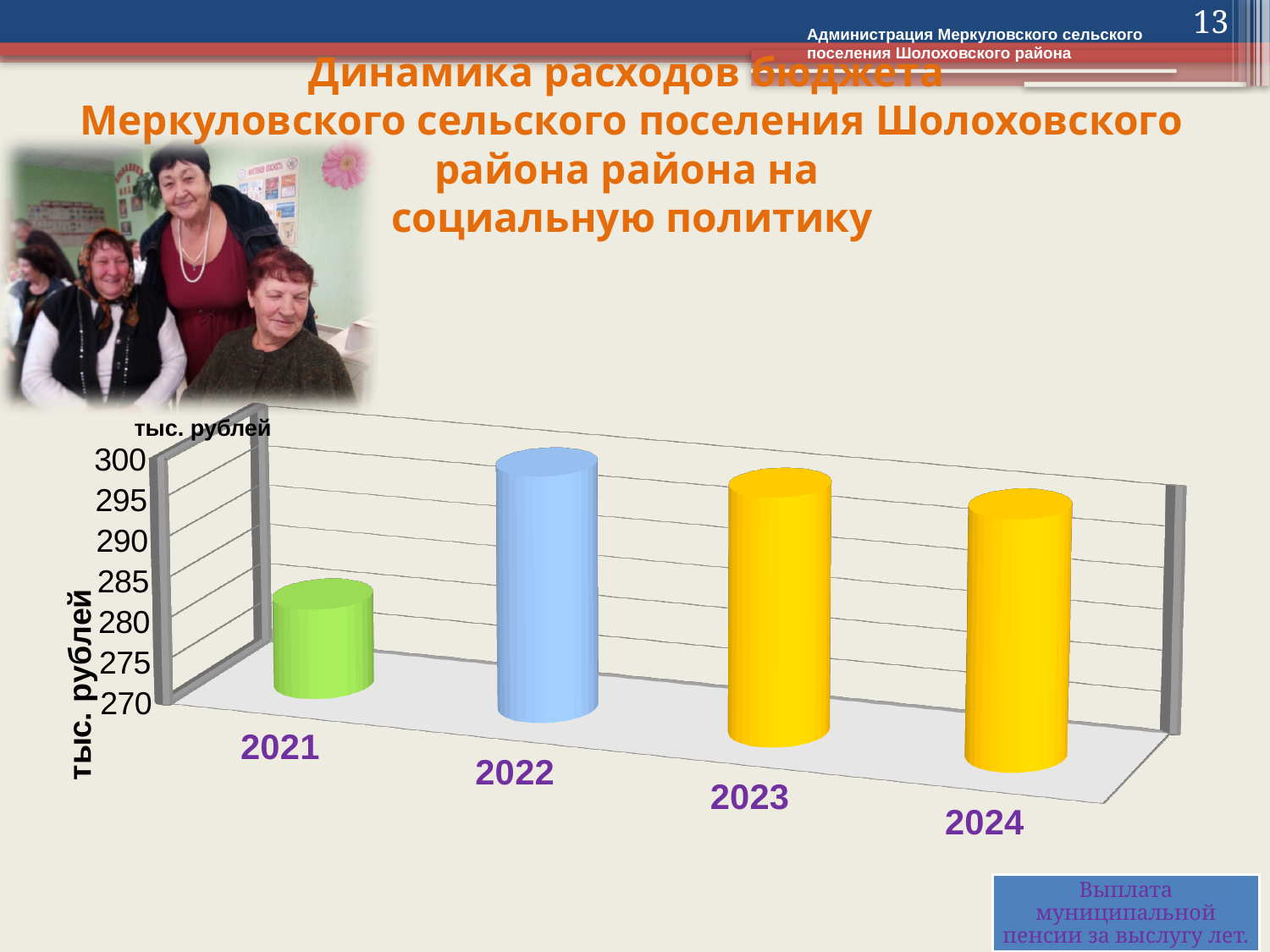
Which year has the lowest value on the chart? 2021 What unit is shown on the vertical axis of the chart? тыс. рублей What kind of chart is shown on the slide? bar chart Which is larger, the value for 2024 or the value for 2021? 2024 Which is larger, the value for 2021 or the value for 2022? 2022 Is the value for 2022 greater or less than 290? greater Is the value for 2024 greater or less than 285? greater Is the value for 2021 greater or less than 275? greater How many years (categories) are plotted on the chart? 4